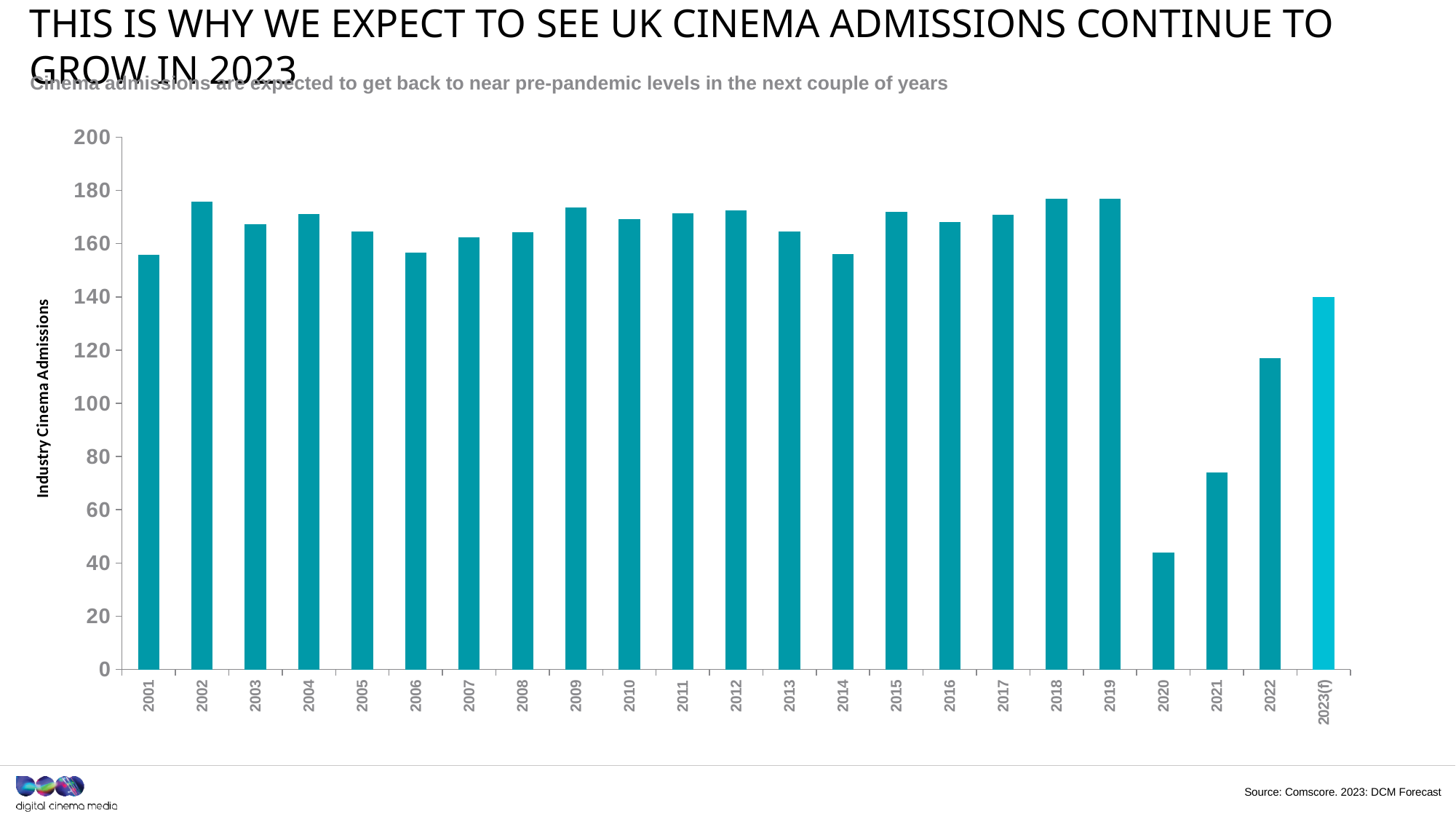
Is the value for 2023(f) greater or less than 120? greater Which is larger, the value for 2022 or the value for 2023(f)? 2023(f) Is the value for 2002 greater or less than 160? greater Is the value for 2020 greater or less than 60? less What kind of chart is shown on the slide? bar chart What is the label on the vertical axis of the chart? Industry Cinema Admissions How many years (bars) are plotted on the chart? 23 Which is larger, the value for 2020 or the value for 2021? 2021 Which year has the lowest industry cinema admissions? 2020 Do the values rise or fall from 2020 to 2023(f)? rise